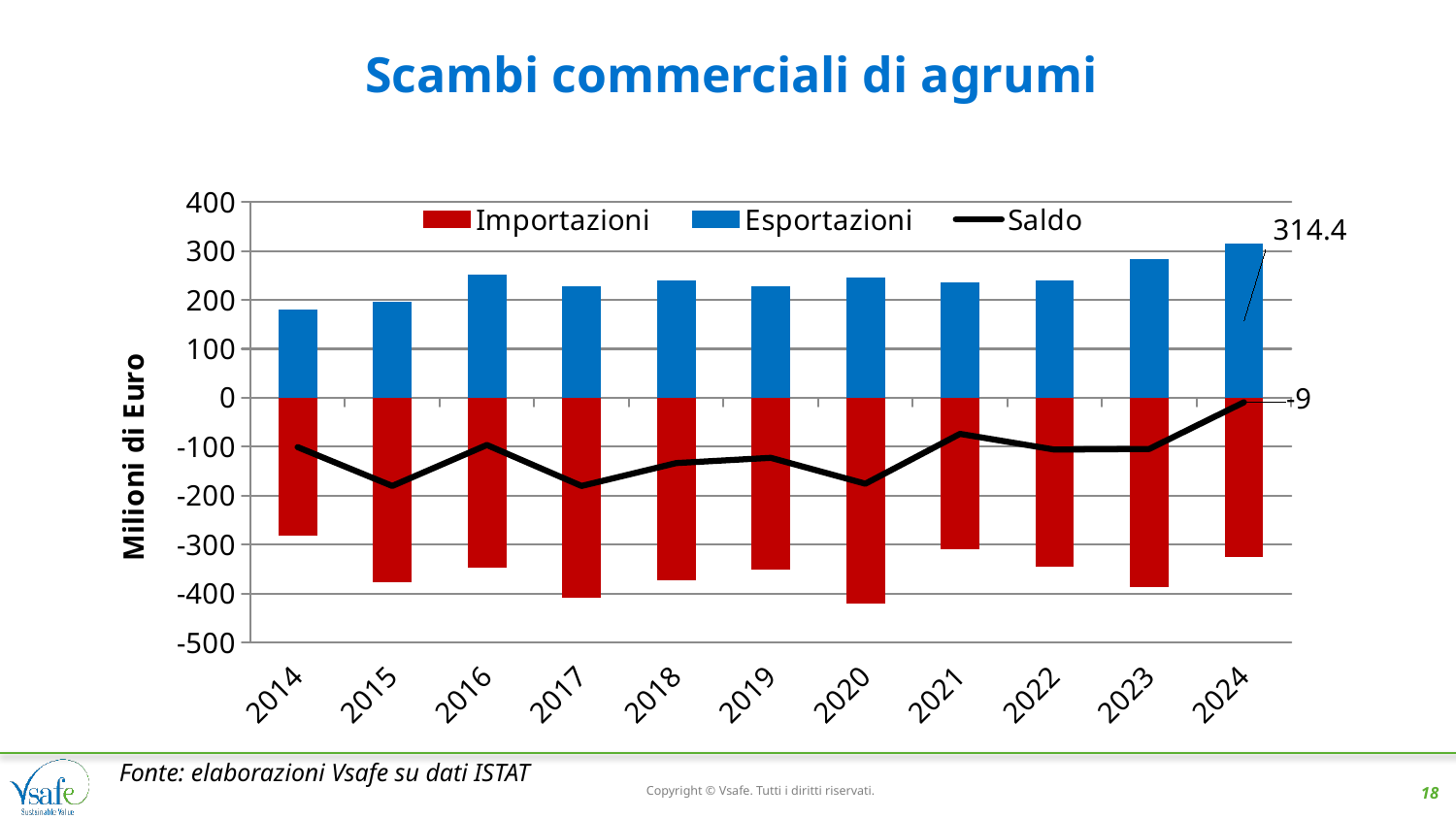
What is the title of the y axis? Milioni di Euro What is the value of Esportazioni in 2024? 314.4 Is the value for Importazioni in 2020 greater or less than -400? less In which year is Esportazioni lowest? 2014 Is the value for Esportazioni in 2023 greater or less than 300? less Is the value for Esportazioni in 2016 greater or less than 200? greater In which year is Saldo highest? 2024 What is the value of Saldo in 2024? -9 How many years are shown on the x axis? 11 How many series does the legend list? 3 In which year is Esportazioni highest? 2024 Does Esportazioni rise or fall from 2021 to 2024? rise